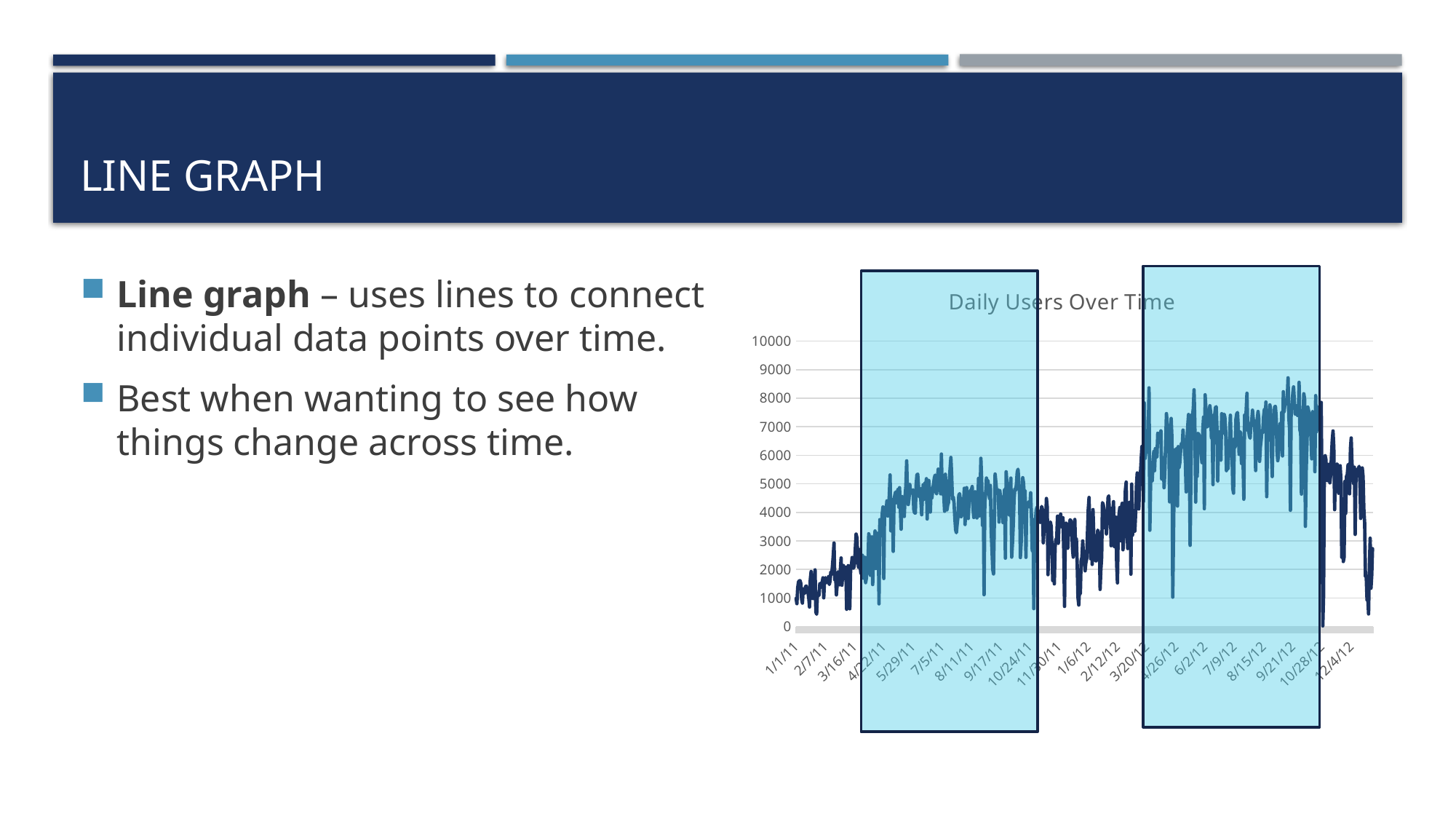
How many highlighted rectangular regions are drawn over the chart? 2 Are the values around 1/6/12 greater or less than 6000? less Is the value at 1/1/11 greater or less than 3000? less Which period has higher daily users: around 7/9/12 or around 1/6/12? around 7/9/12 Do the values generally rise or fall from 10/28/12 to the end of the series? fall Which period has lower daily users: around 1/1/11 or around 8/15/12? around 1/1/11 What is the title of the chart? Daily Users Over Time Is the highest point reached by the line greater or less than 8000? greater What is the highest value shown on the chart's vertical axis? 10000 What kind of chart is shown on the slide? line chart Do the values generally rise or fall between 1/1/11 and 7/5/11? rise